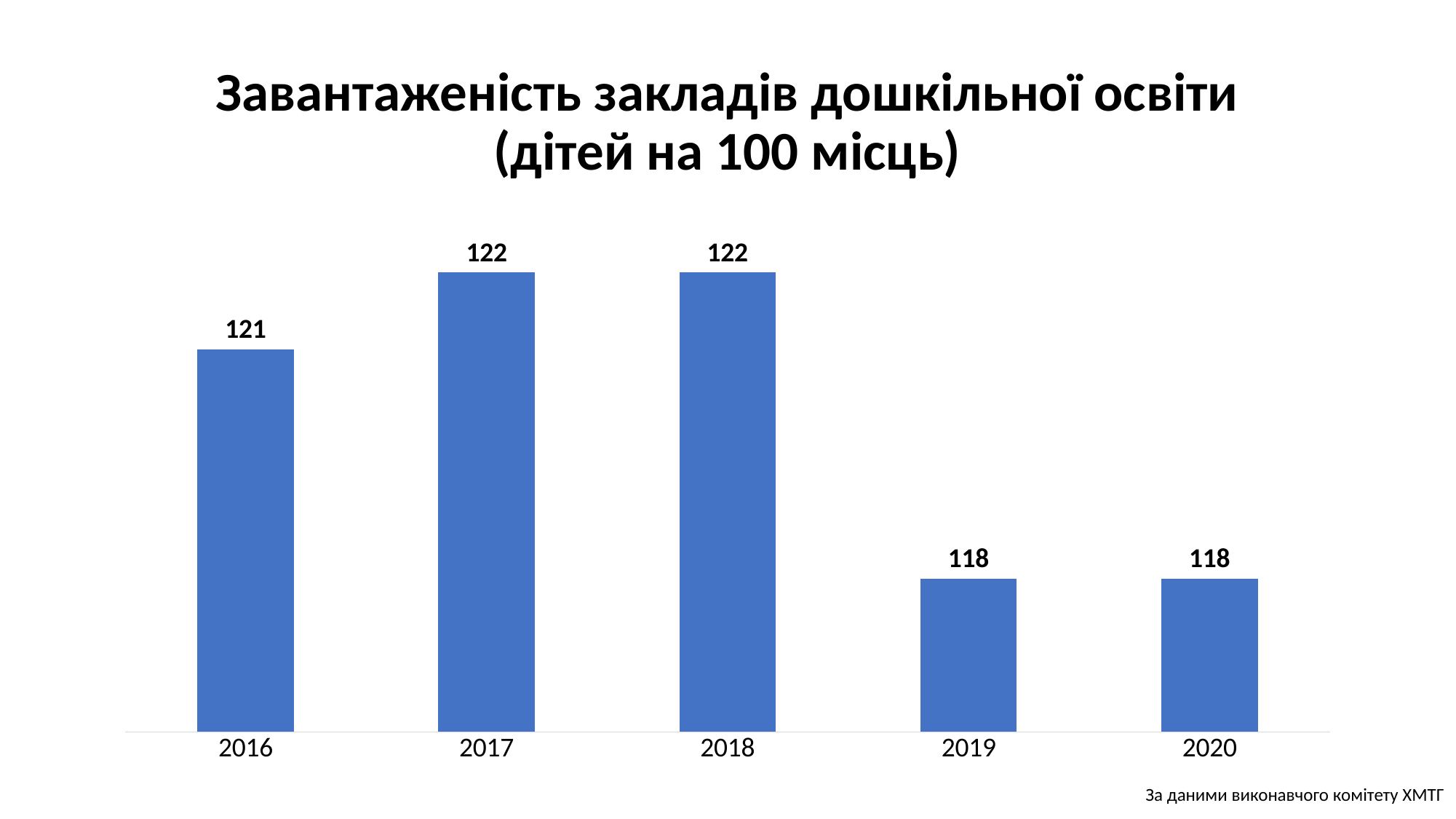
What is the value for 2019? 118 What kind of chart is shown on the slide? Bar chart What is the highest value shown on the chart? 122 Which year has the larger value, 2016 or 2019? 2016 How many years are shown on the chart? 5 What is the difference between the values for 2016 and 2020? 3 What is the value for 2020? 118 What is the value for 2016? 121 What is the title of the chart? Завантаженість закладів дошкільної освіти (дітей на 100 місць) What is the lowest value shown on the chart? 118 What is the value for 2017? 122 What is the difference between the values for 2018 and 2019? 4